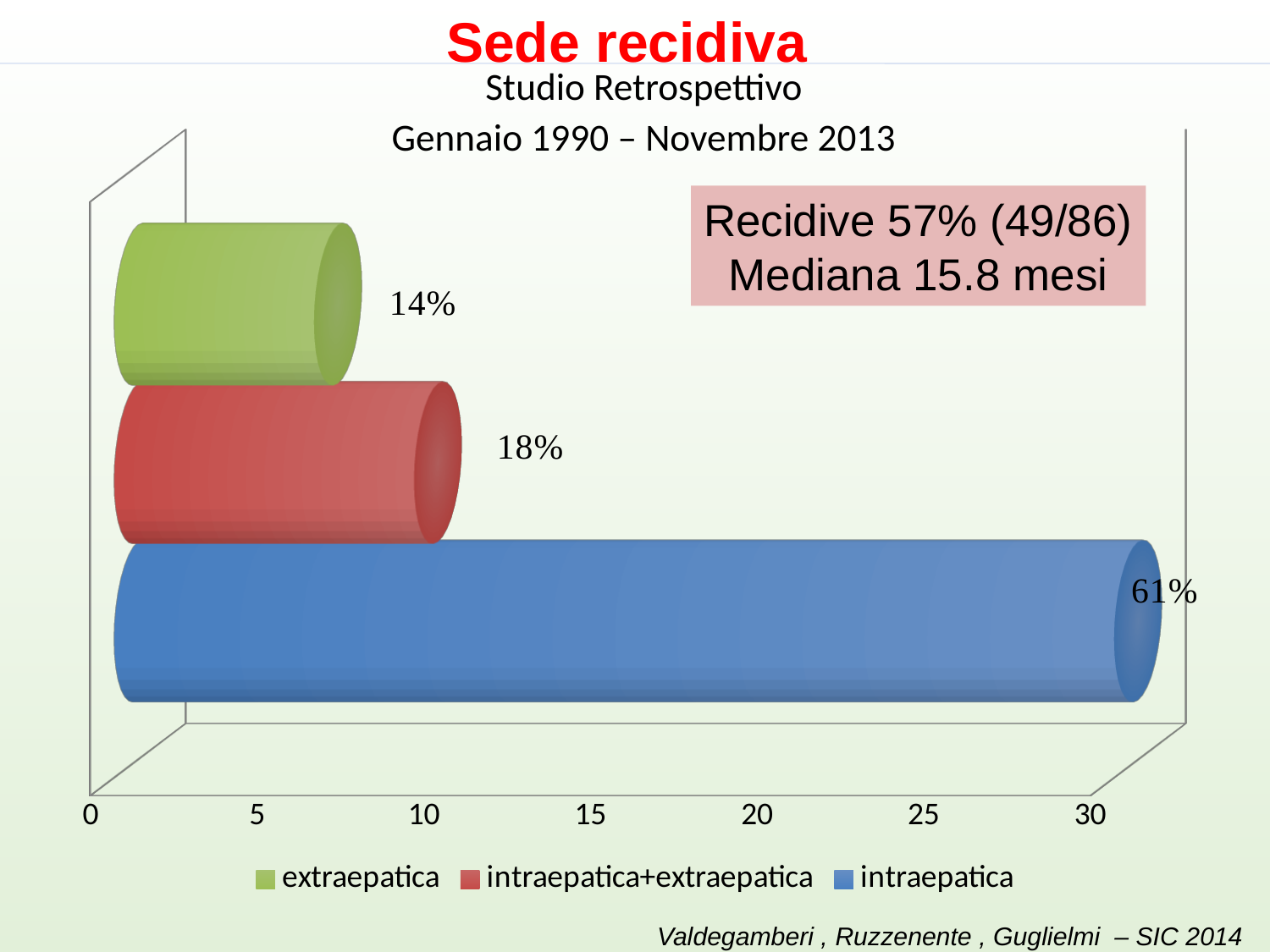
Which is larger, the value for intraepatica or the value for intraepatica+extraepatica? intraepatica Which series has the longest bar? intraepatica What kind of chart is shown on the slide? bar chart What is the difference between the labelled percentages for intraepatica and extraepatica? 47% Is the bar for extraepatica greater or less than 5 on the axis? greater What data label is shown on the bar for extraepatica? 14% Is the bar for intraepatica greater or less than 25 on the axis? greater What data label is shown on the bar for intraepatica+extraepatica? 18% How many series does the legend list? 3 What is the difference between the labelled percentages for intraepatica+extraepatica and extraepatica? 4% What data label is shown on the bar for intraepatica? 61% Which series has the shortest bar? extraepatica